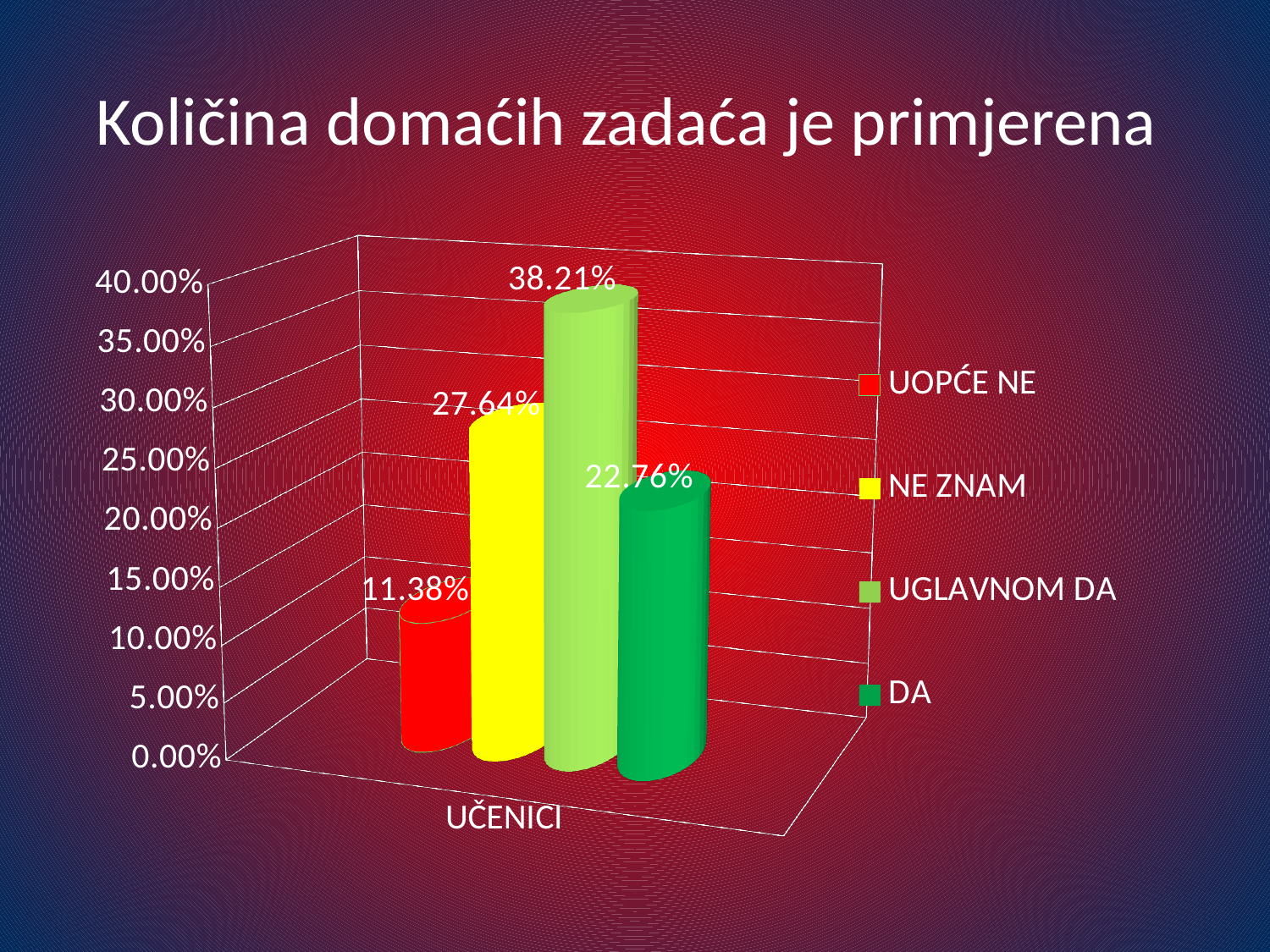
What is the difference between the values for UGLAVNOM DA and DA? 15.45% What is the value for DA? 22.76% What is the value for UOPĆE NE? 11.38% Which series has the lowest value? UOPĆE NE What is the title of the chart on the slide? Količina domaćih zadaća je primjerena What kind of chart is shown on the slide? bar chart How many series does the legend list? 4 Is the value for DA greater or less than 25.00%? less What is the value for UGLAVNOM DA? 38.21% What is the value for NE ZNAM? 27.64% Which series has the highest value? UGLAVNOM DA Which is larger, the value for NE ZNAM or the value for DA? NE ZNAM